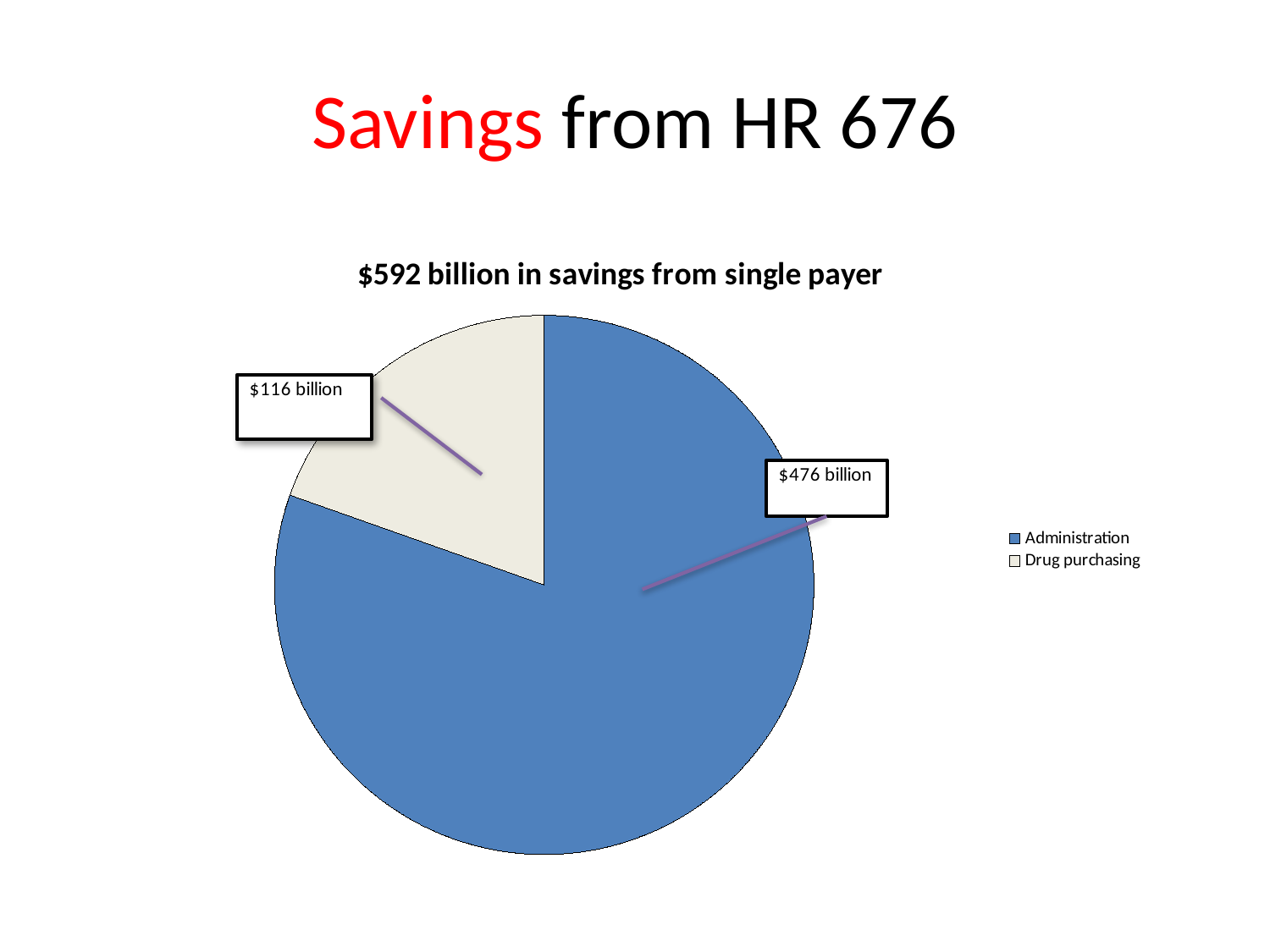
Which colour represents Administration in the pie chart? blue How much larger is the Administration value than the Drug purchasing value? $360 billion How many entries does the legend list? 2 What is the value for Administration? $476 billion What is the chart's title? $592 billion in savings from single payer What is the total of the two slices? $592 billion Which category has the smallest slice? Drug purchasing What kind of chart is shown on the slide? pie chart What is the value for Drug purchasing? $116 billion How many slices does the pie chart have? 2 Which is larger, Administration or Drug purchasing? Administration Which category has the largest slice? Administration